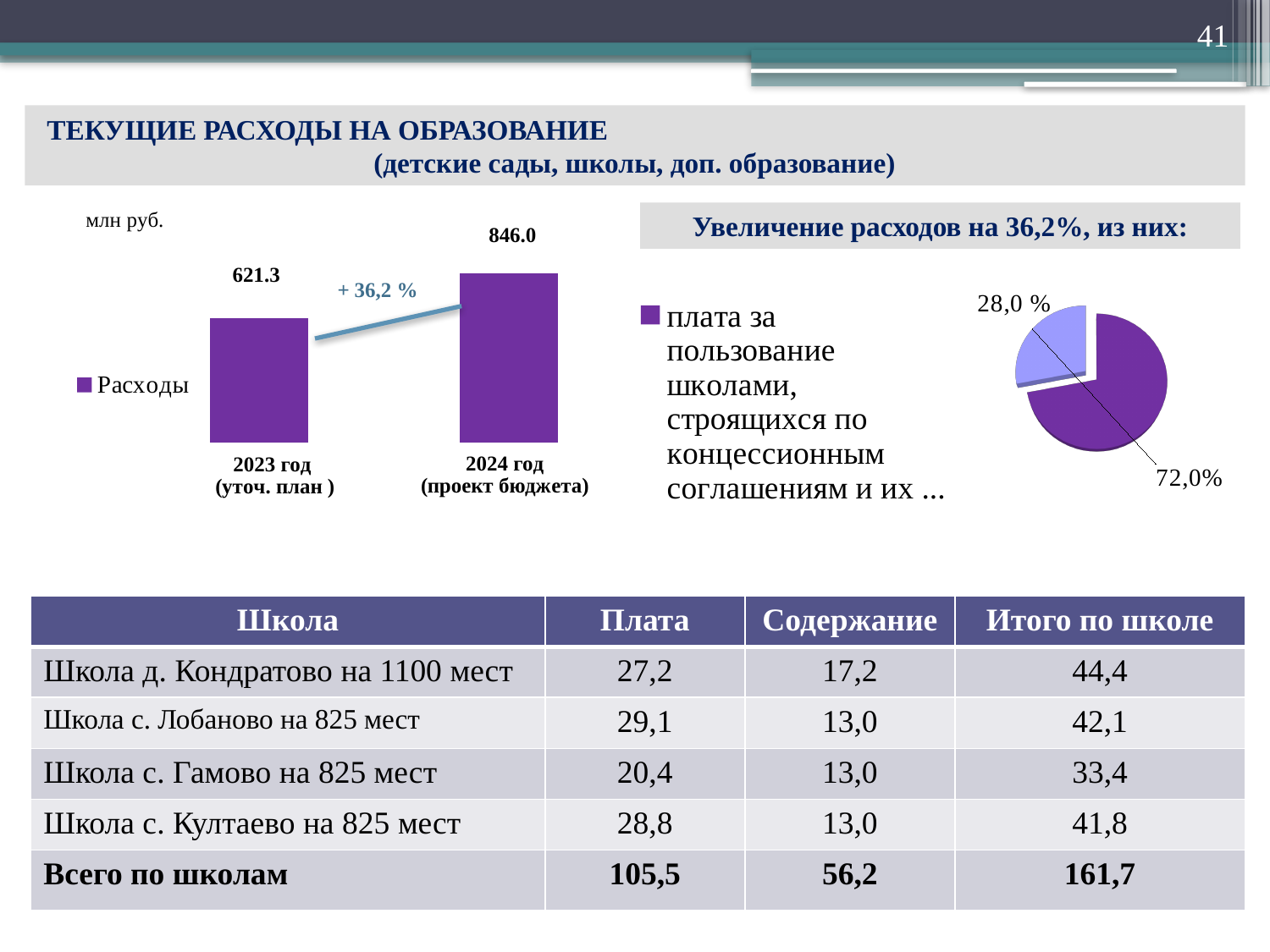
On the bar chart, which year has the higher value of Расходы? 2024 год (проект бюджета) How many series does the legend of the bar chart list? 1 What percentage change is annotated between the two bars on the bar chart? + 36,2 % On the bar chart, which year has the lower value of Расходы? 2023 год (уточ. план) On the bar chart, what is the difference between the 2024 and 2023 values of Расходы? 224.7 What type of chart is the chart on the left showing Расходы? bar chart On the bar chart, what is the value of Расходы for 2024 год (проект бюджета)? 846.0 On the pie chart, what share does the larger slice have? 72,0% How many categories (years) are shown on the bar chart? 2 On the bar chart, what is the value of Расходы for 2023 год (уточ. план)? 621.3 How many slices does the pie chart have? 2 On the bar chart, do the values rise or fall from 2023 to 2024? rise